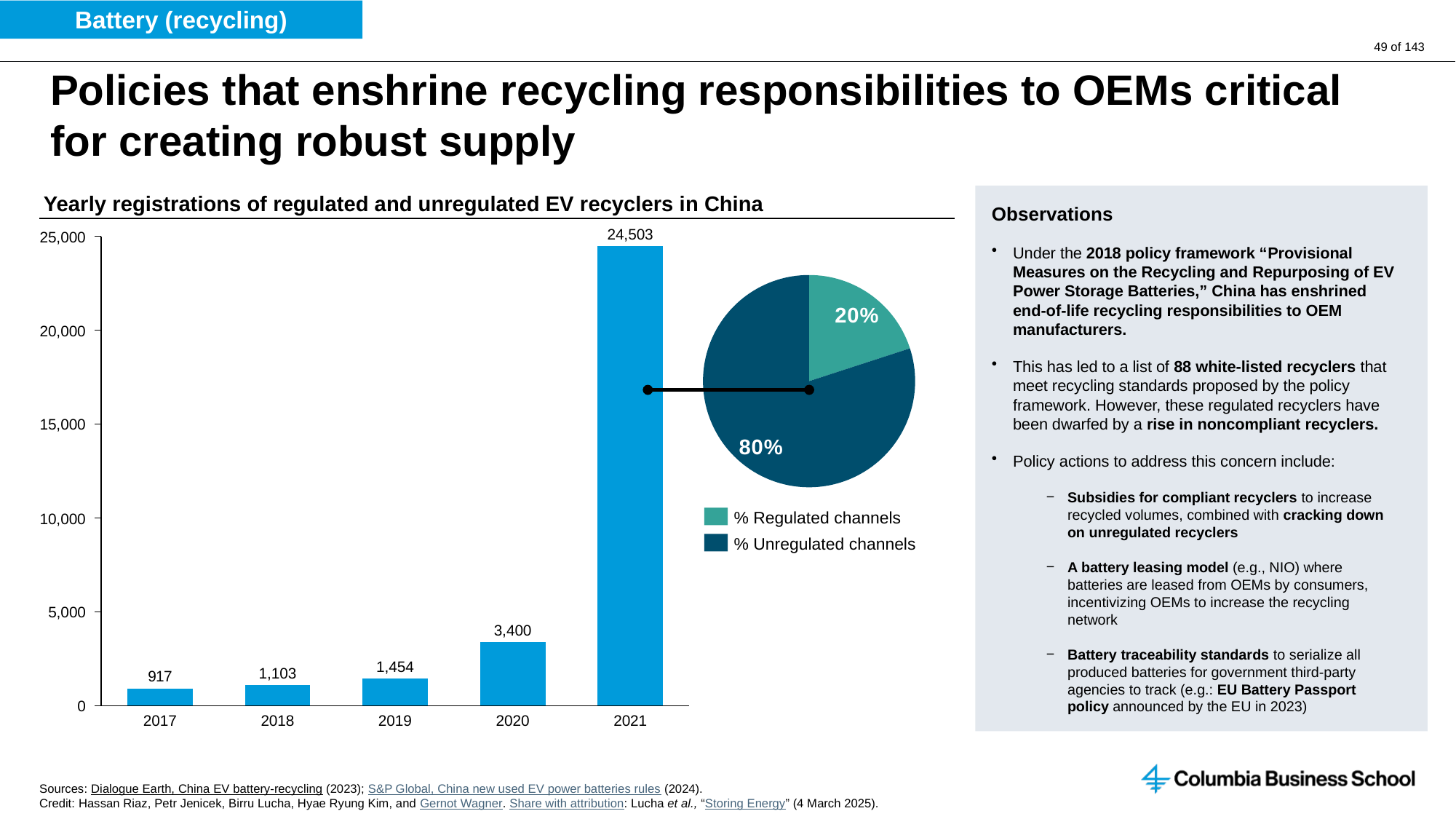
In the bar chart of yearly registrations of EV recyclers in China, which year has the lowest value? 2017 In the bar chart of yearly registrations of EV recyclers in China, how many years are shown on the x axis? 5 How many entries does the pie chart legend list? 2 In the bar chart of yearly registrations of EV recyclers in China, what is the value for 2021? 24,503 In the pie chart, what share is labelled for % Unregulated channels? 80% In the bar chart of yearly registrations of EV recyclers in China, what is the difference between the 2020 and 2019 values? 1,946 In the bar chart of yearly registrations of EV recyclers in China, which is larger, the value for 2018 or the value for 2019? 2019 In the bar chart of yearly registrations of EV recyclers in China, what is the value for 2019? 1,454 In the bar chart of yearly registrations of EV recyclers in China, which year has the highest value? 2021 In the bar chart of yearly registrations of EV recyclers in China, do the values rise or fall from 2017 to 2021? rise In the pie chart, what share is labelled for % Regulated channels? 20% In the bar chart of yearly registrations of EV recyclers in China, what is the value for 2017? 917